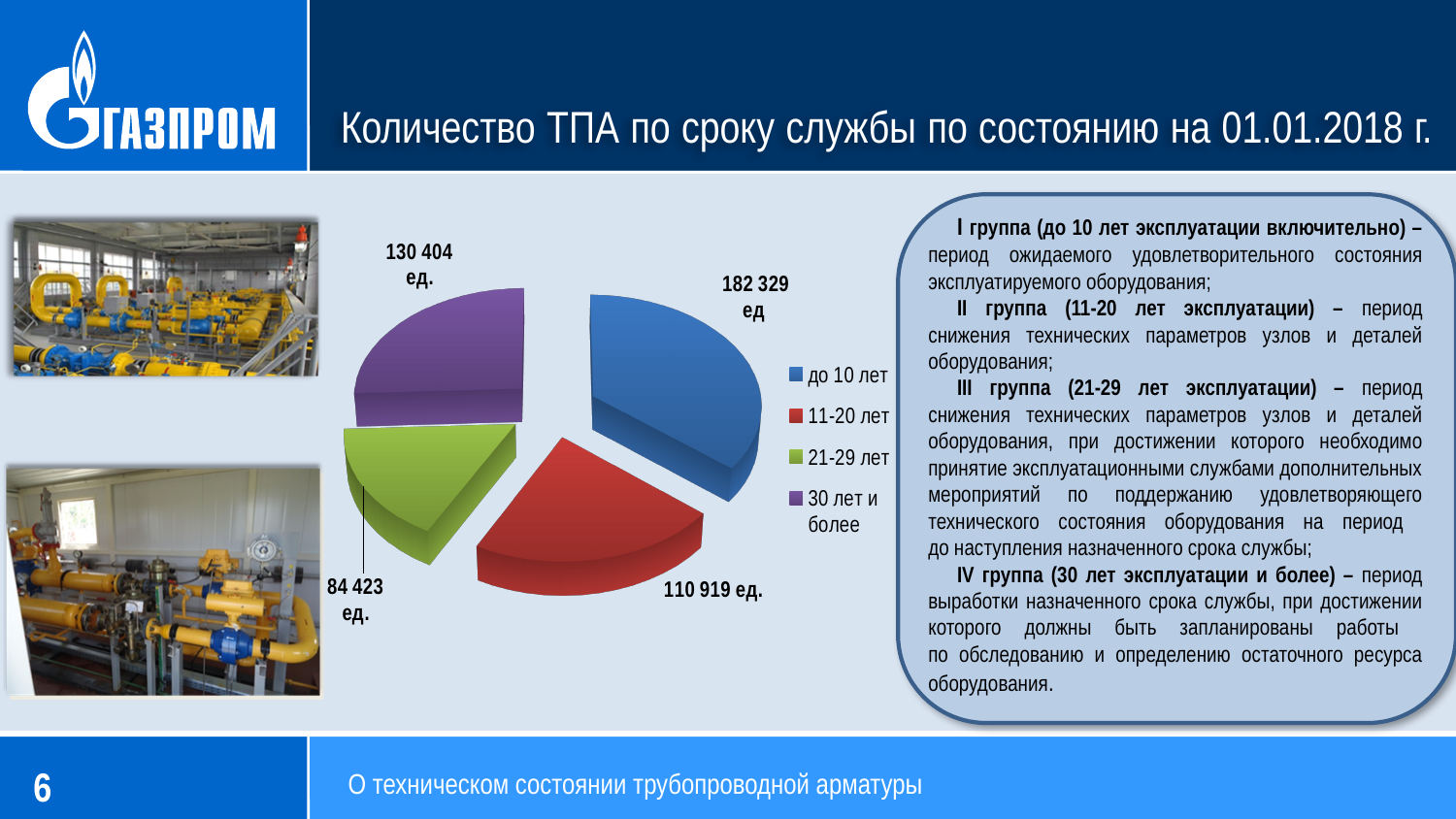
What is the value for the "11-20 лет" slice? 110 919 ед. What is the difference between the "до 10 лет" and "11-20 лет" values? 71 410 What type of chart is shown on the slide? Pie chart Which category has the smallest value? 21-29 лет What is the difference between the "30 лет и более" and "21-29 лет" values? 45 981 What is the value for the "30 лет и более" slice? 130 404 ед. Which is larger: the value for "30 лет и более" or for "11-20 лет"? 30 лет и более Which category has the largest value? до 10 лет What is the value for the "до 10 лет" slice? 182 329 ед What is the value for the "21-29 лет" slice? 84 423 ед. What colour is the "21-29 лет" slice? Green How many categories does the pie chart have? 4